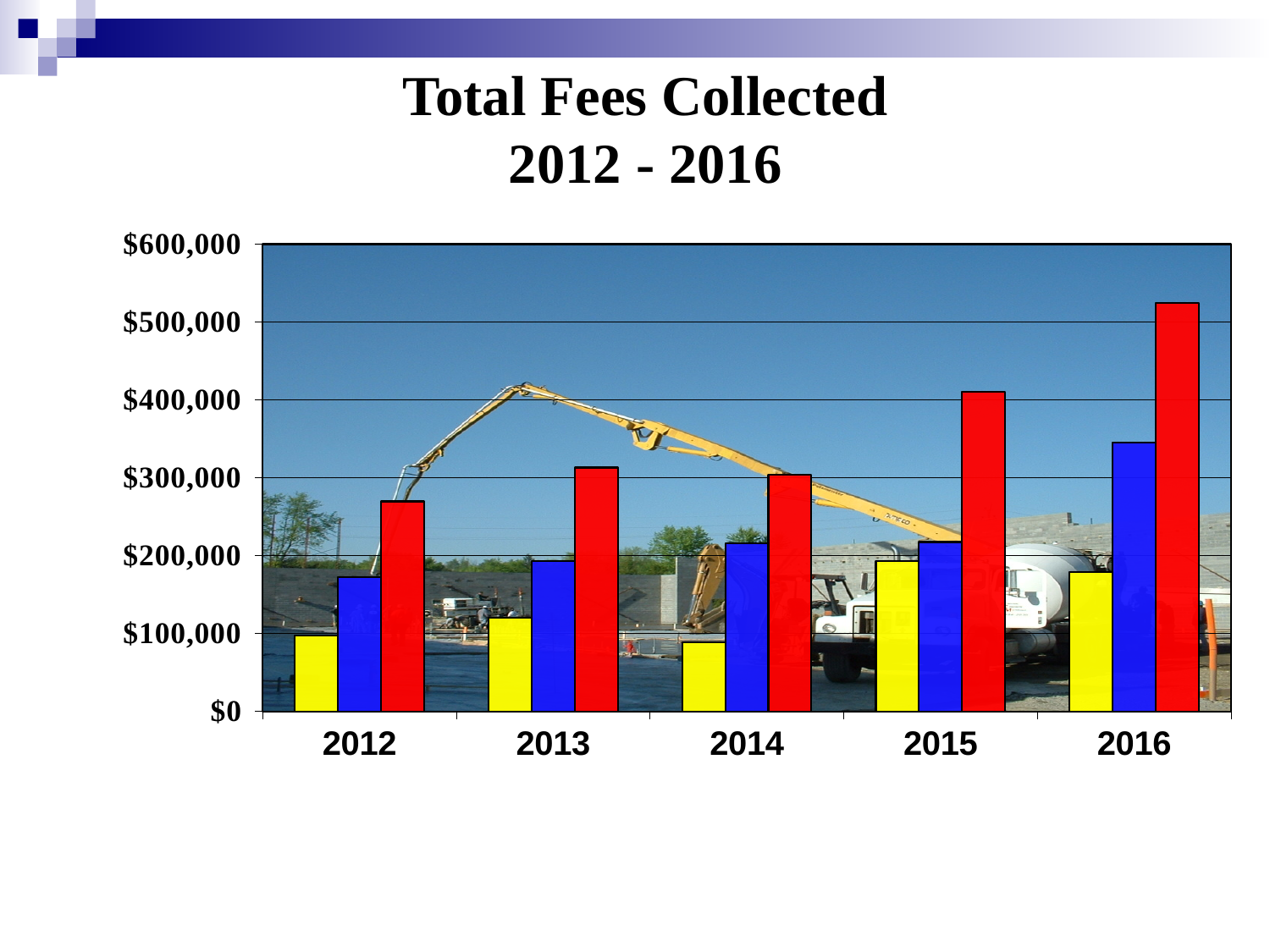
Which year has the tallest blue bar? 2016 Which is larger, the red bar for 2015 or the red bar for 2016? 2016 How many years are shown on the x axis? 5 Is the yellow bar for 2014 greater or less than $100,000? less What is the title of the chart? Total Fees Collected 2012 - 2016 Is the red bar for 2012 greater or less than $300,000? less What kind of chart is shown on the slide? bar chart Is the blue bar for 2016 greater or less than $300,000? greater Do the blue bars generally rise or fall from 2012 to 2016? rise Which year has the tallest yellow bar? 2015 Which year has the tallest red bar? 2016